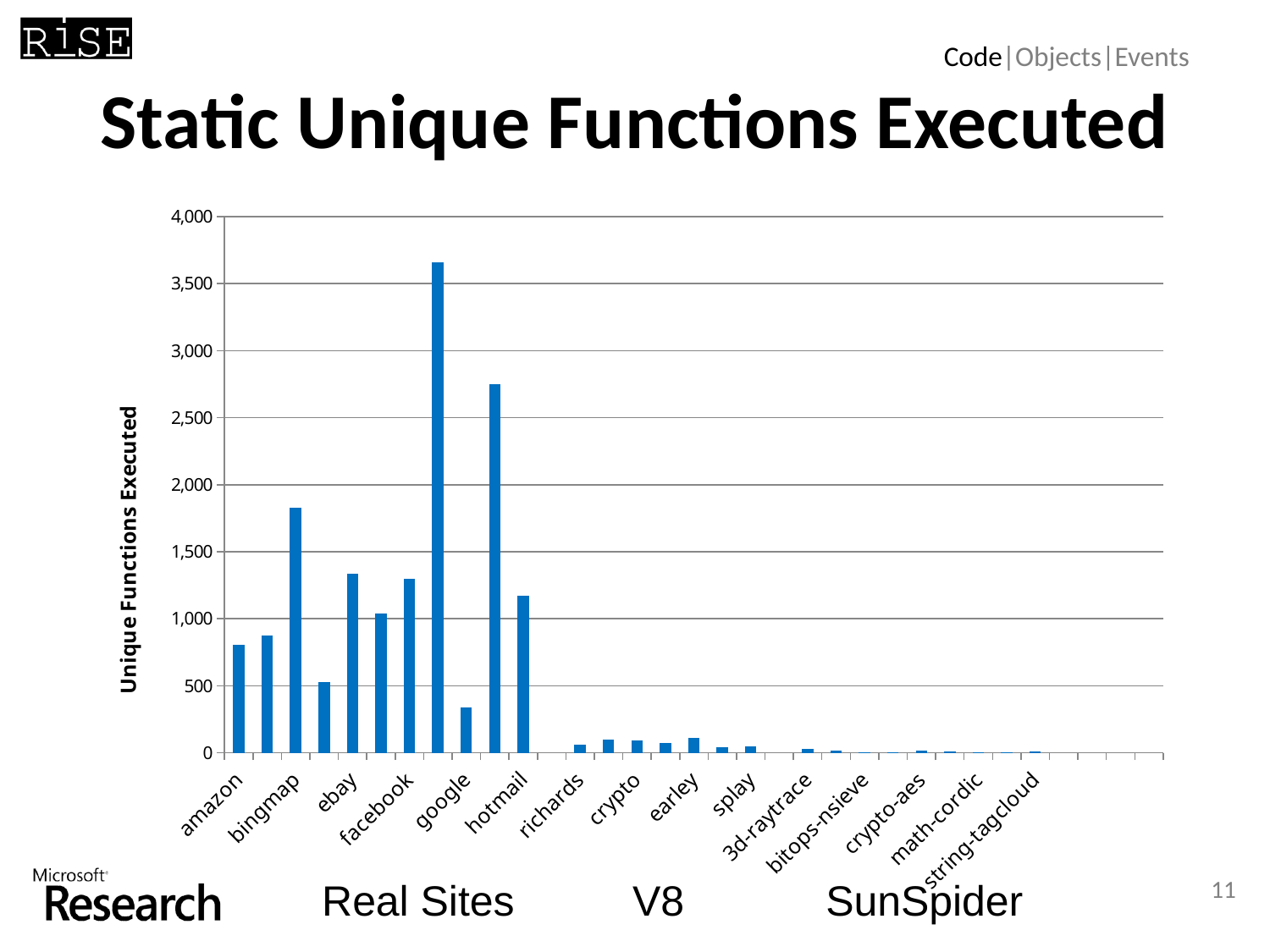
Is the tallest bar in the chart greater or less than 3,500? greater Which has a larger value, bingmap or amazon? bingmap Is the value for google greater or less than 500? less What kind of chart is shown on the slide? bar chart Is the value for hotmail greater or less than 1,000? greater What is the title of the chart? Static Unique Functions Executed Which group of benchmarks (Real Sites, V8, or SunSpider) has the tallest bars? Real Sites Which has a larger value, google or hotmail? hotmail What is the label on the vertical axis? Unique Functions Executed Do the bar values generally rise or fall moving from the Real Sites group to the SunSpider group along the x axis? fall